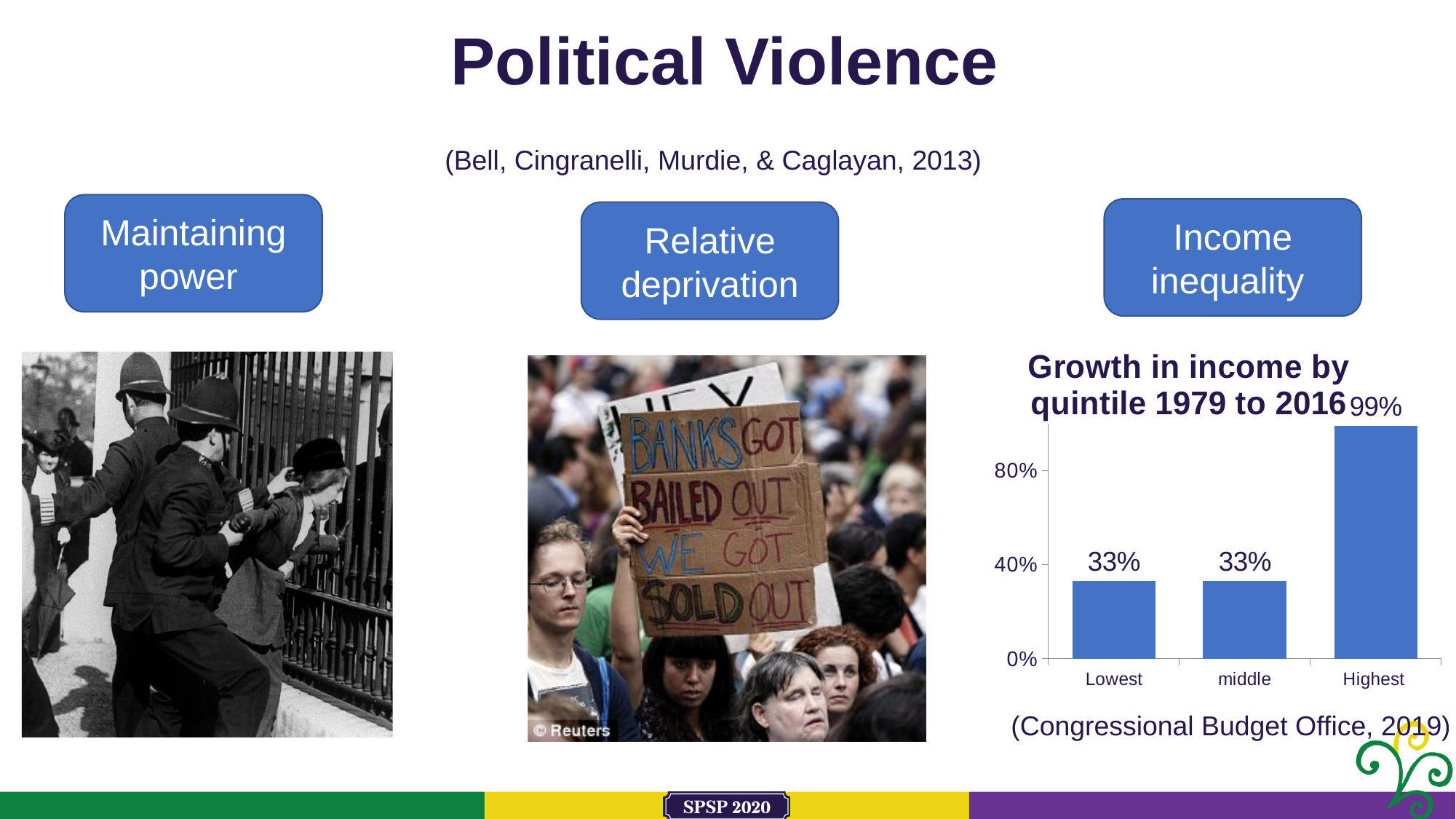
What kind of chart is shown on the slide? bar chart What is the growth in income for the Highest quintile? 99% What is the growth in income for the middle quintile? 33% What is the title of the chart? Growth in income by quintile 1979 to 2016 Is the value for the Lowest quintile greater or less than 40%? less How many quintile categories are shown in the chart? 3 What is the growth in income for the Lowest quintile? 33% Is the value for the Highest quintile greater or less than 80%? greater Which quintile has the highest growth in income? Highest What is the difference in income growth between the Highest and Lowest quintiles? 66% What source is cited below the chart? Congressional Budget Office, 2019 Which has larger income growth, the Highest quintile or the middle quintile? Highest